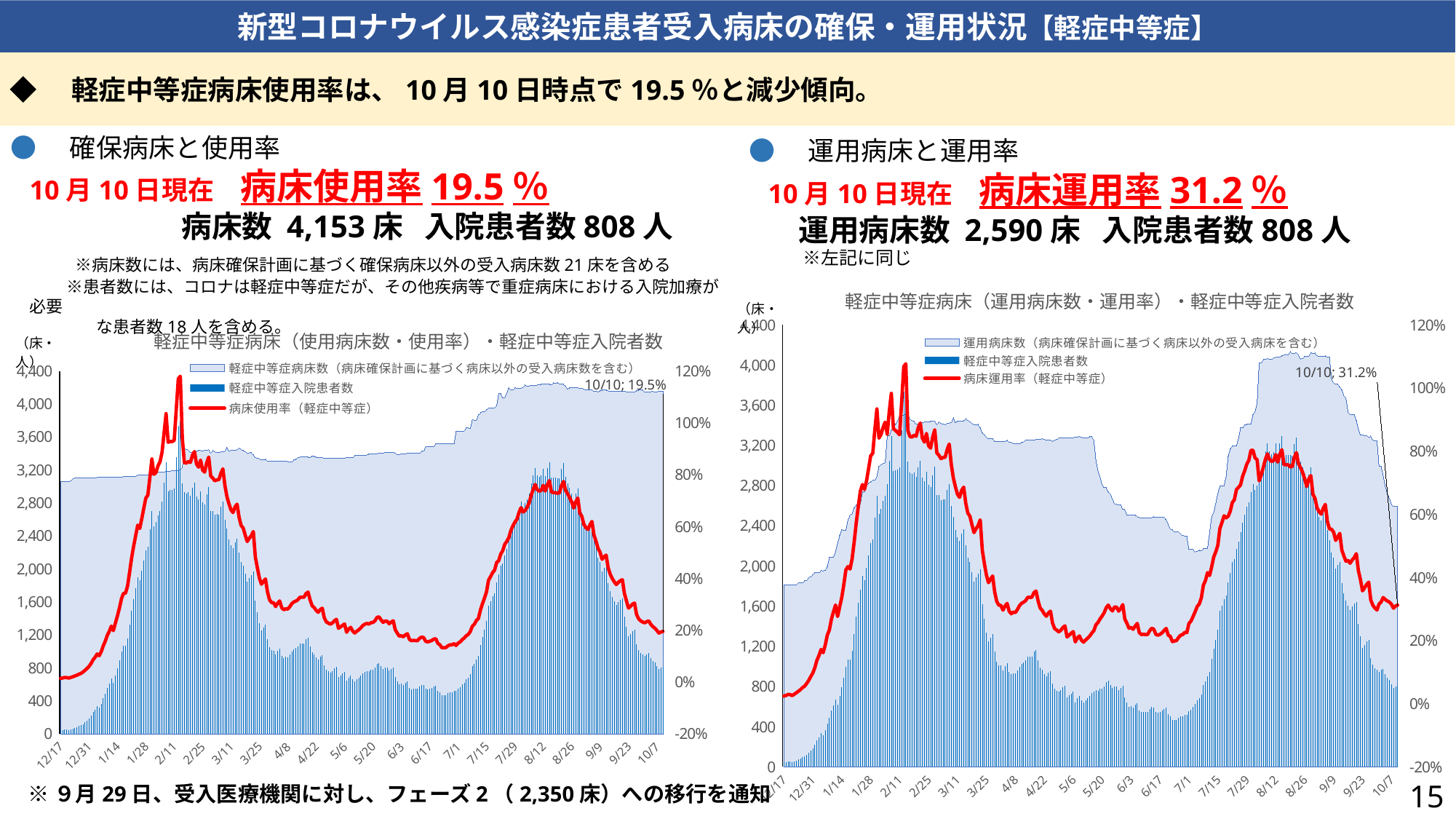
On the left chart (軽症中等症病床（使用病床数・使用率）・軽症中等症入院者数), what value is printed at the data label for 10/10? 19.5% On the right chart, which series is drawn as a red line? 病床運用率（軽症中等症） On the right chart, is the 病床運用率 value around 6/17 greater or less than 40%? less Comparing the 10/10 data labels, which chart shows the larger rate, the left chart or the right chart? the right chart How many series does the legend of the left chart list? 3 On the left chart, which series is drawn as a red line? 病床使用率（軽症中等症） On the right chart, is the 病床運用率 value around 8/12 greater or less than 60%? greater On the right chart (軽症中等症病床（運用病床数・運用率）・軽症中等症入院者数), what value is printed at the data label for 10/10? 31.2% On the left chart, is the 病床使用率 value around 2/11 greater or less than 100%? greater What is the difference between the 10/10 rate on the right chart and the 10/10 rate on the left chart? 11.7% How many series does the legend of the right chart list? 3 On the left chart, does the 病床使用率 line rise or fall between 8/26 and 10/7? fall